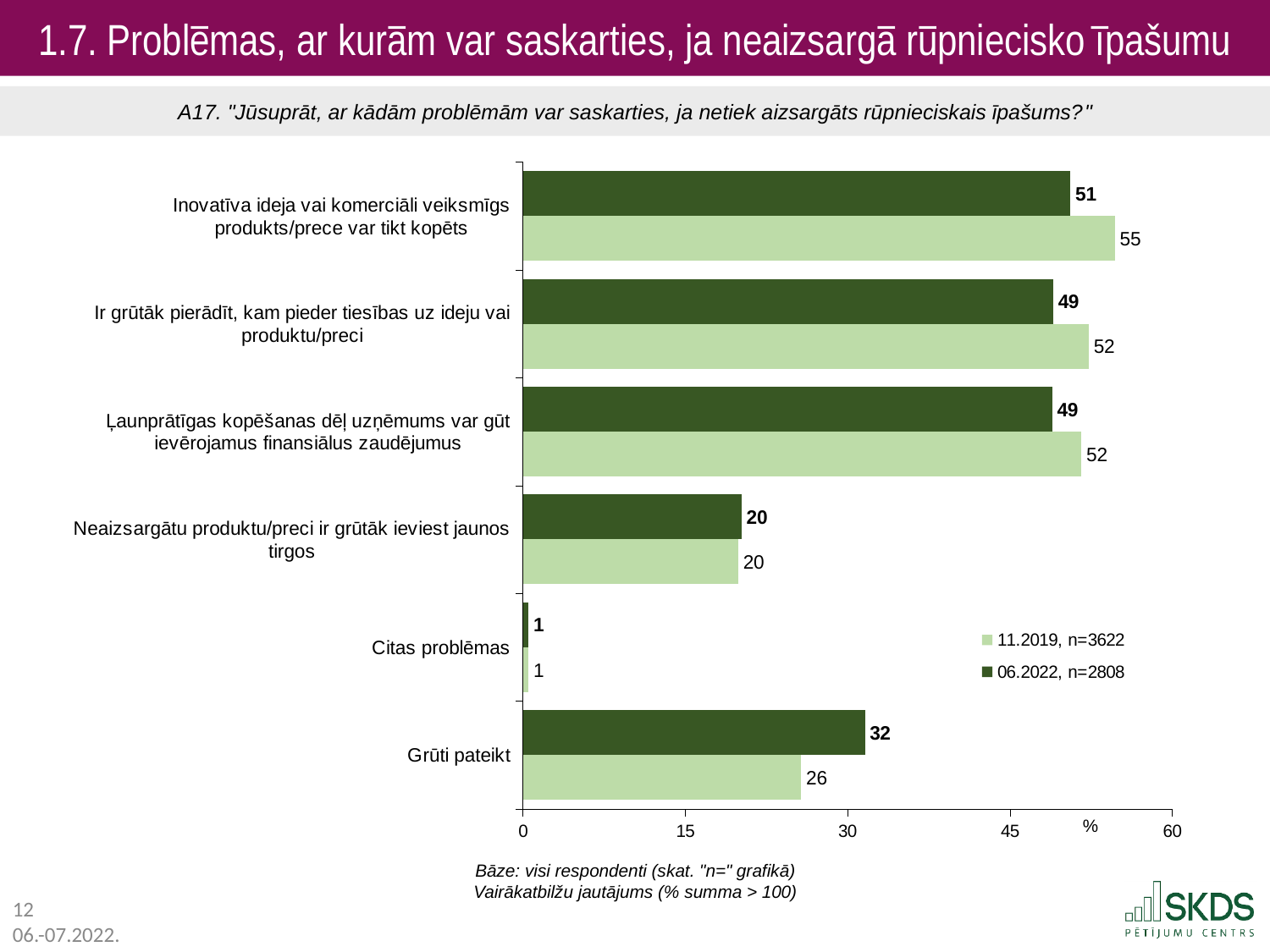
What is the value for "Grūti pateikt" in the 06.2022, n=2808 series? 32 Which category has the highest value in the 11.2019, n=3622 series? Inovatīva ideja vai komerciāli veiksmīgs produkts/prece var tikt kopēts For "Ir grūtāk pierādīt, kam pieder tiesības uz ideju vai produktu/preci", which series has the larger value, 11.2019 or 06.2022? 11.2019 Which category has the lowest value in the 06.2022, n=2808 series? Citas problēmas What kind of chart is shown on the slide? bar chart What is the difference between the 11.2019 and 06.2022 values for "Grūti pateikt"? 6 What is the value for "Inovatīva ideja vai komerciāli veiksmīgs produkts/prece var tikt kopēts" in the 06.2022, n=2808 series? 51 How many series does the legend list? 2 What is the sample size (n) shown in the legend for the 06.2022 series? n=2808 How many categories are shown on the chart? 6 What is the value for "Neaizsargātu produktu/preci ir grūtāk ieviest jaunos tirgos" in the 11.2019, n=3622 series? 20 What is the value for "Inovatīva ideja vai komerciāli veiksmīgs produkts/prece var tikt kopēts" in the 11.2019, n=3622 series? 55